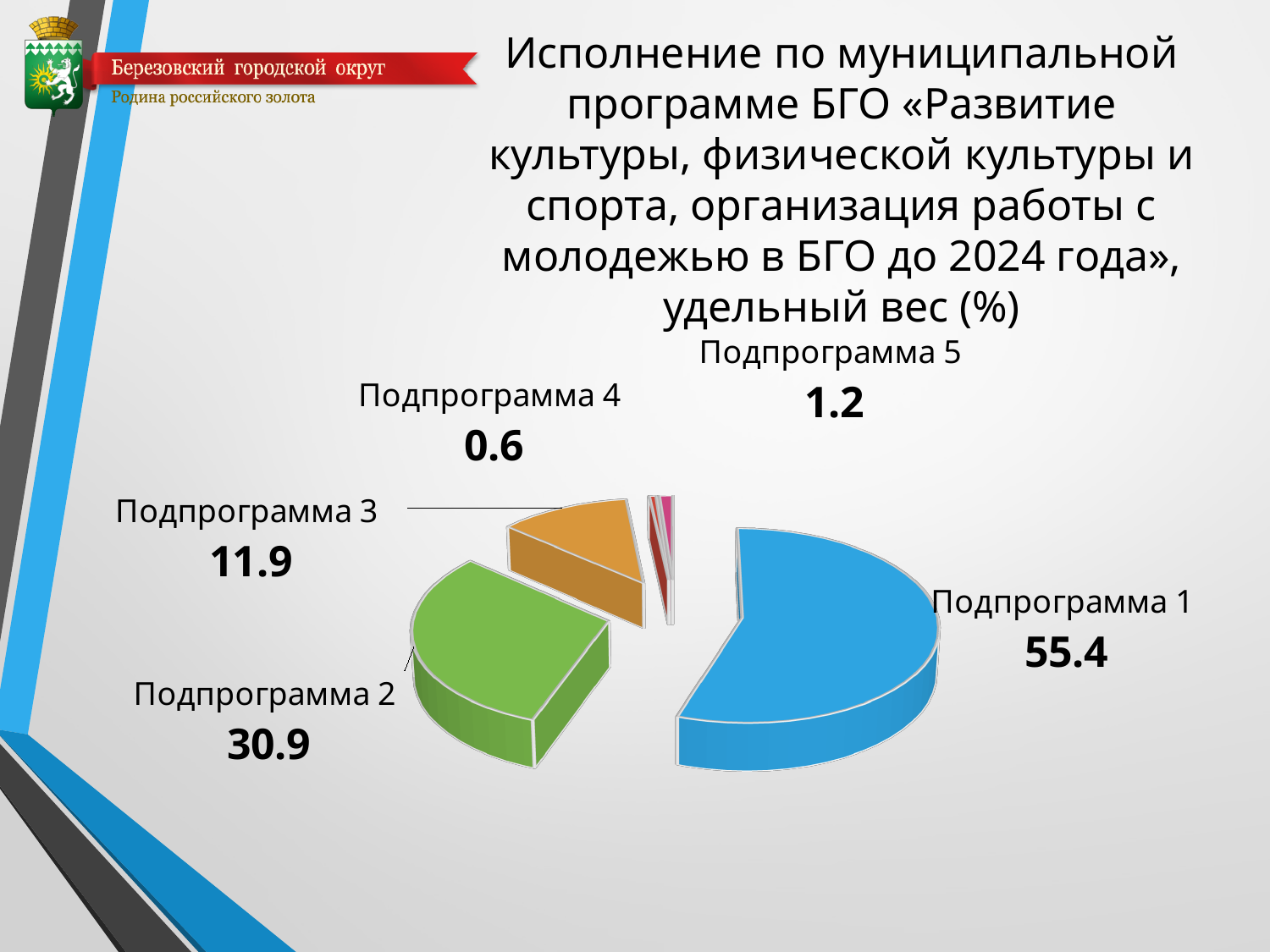
Which subprogram has the smallest share of the pie? Подпрограмма 4 What is the value shown for Подпрограмма 5? 1.2 What is the difference between the values for Подпрограмма 1 and Подпрограмма 2? 24.5 What kind of chart is shown on the slide? Pie chart Which is larger, the value for Подпрограмма 3 or the value for Подпрограмма 5? Подпрограмма 3 What is the value shown for Подпрограмма 3? 11.9 What colour is the slice for Подпрограмма 2? Green What is the difference between the values for Подпрограмма 5 and Подпрограмма 4? 0.6 Which subprogram has the largest share of the pie? Подпрограмма 1 How many slices does the pie chart have? 5 What is the value shown for Подпрограмма 1? 55.4 What is the value shown for Подпрограмма 2? 30.9